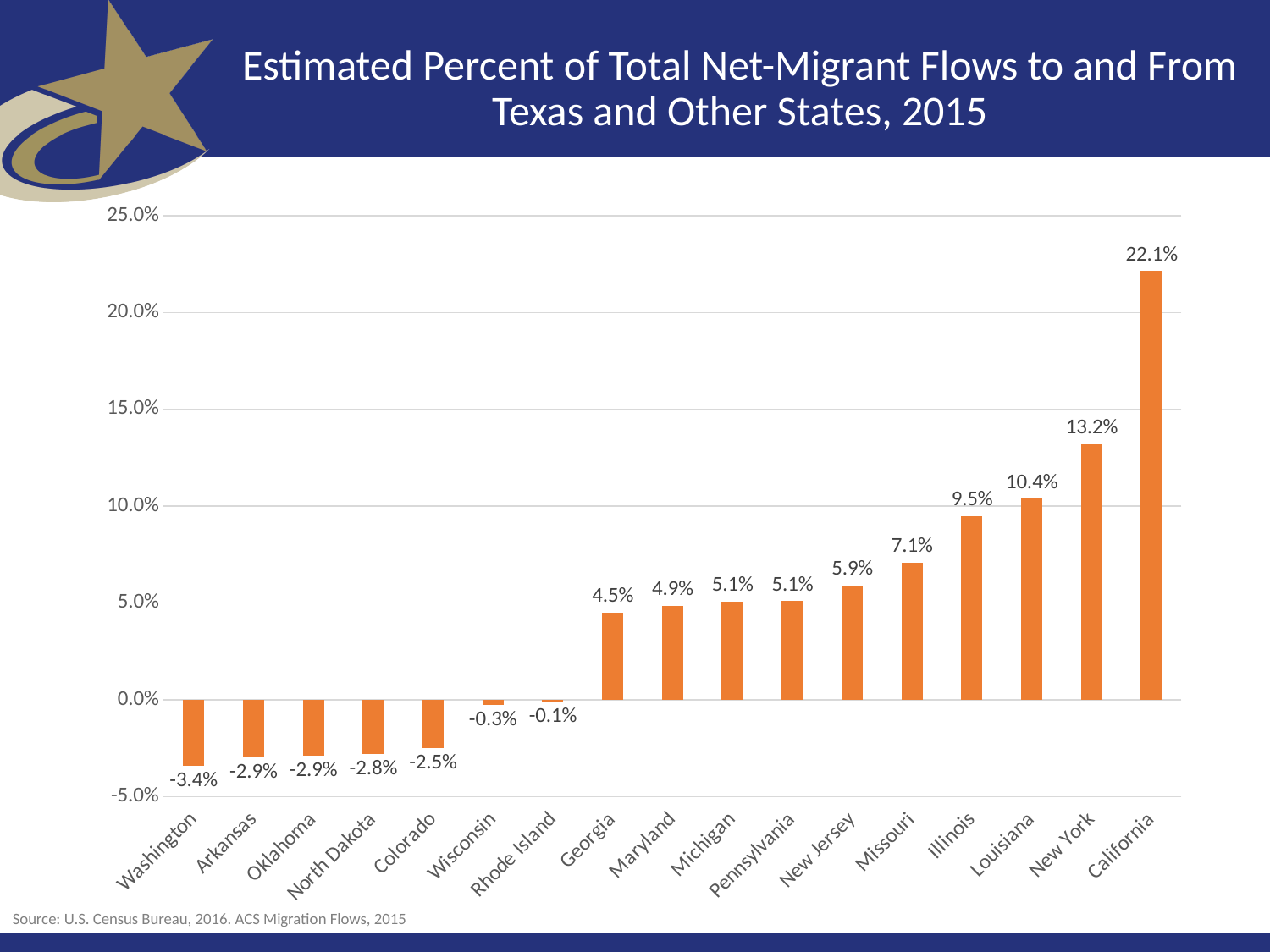
Which is larger, the value for Illinois or the value for Louisiana? Louisiana Which state has the highest value? California What is the value for California? 22.1% What kind of chart is this? Bar chart What is the value for Washington? -3.4% How many states are shown on the x axis? 17 What is the value for Missouri? 7.1% What is the difference between the values for California and New York? 8.9% Is the value for New York greater or less than 10.0%? greater Which state has the lowest value? Washington What is the value for Rhode Island? -0.1% Do the values rise or fall from left to right along the x axis? Rise